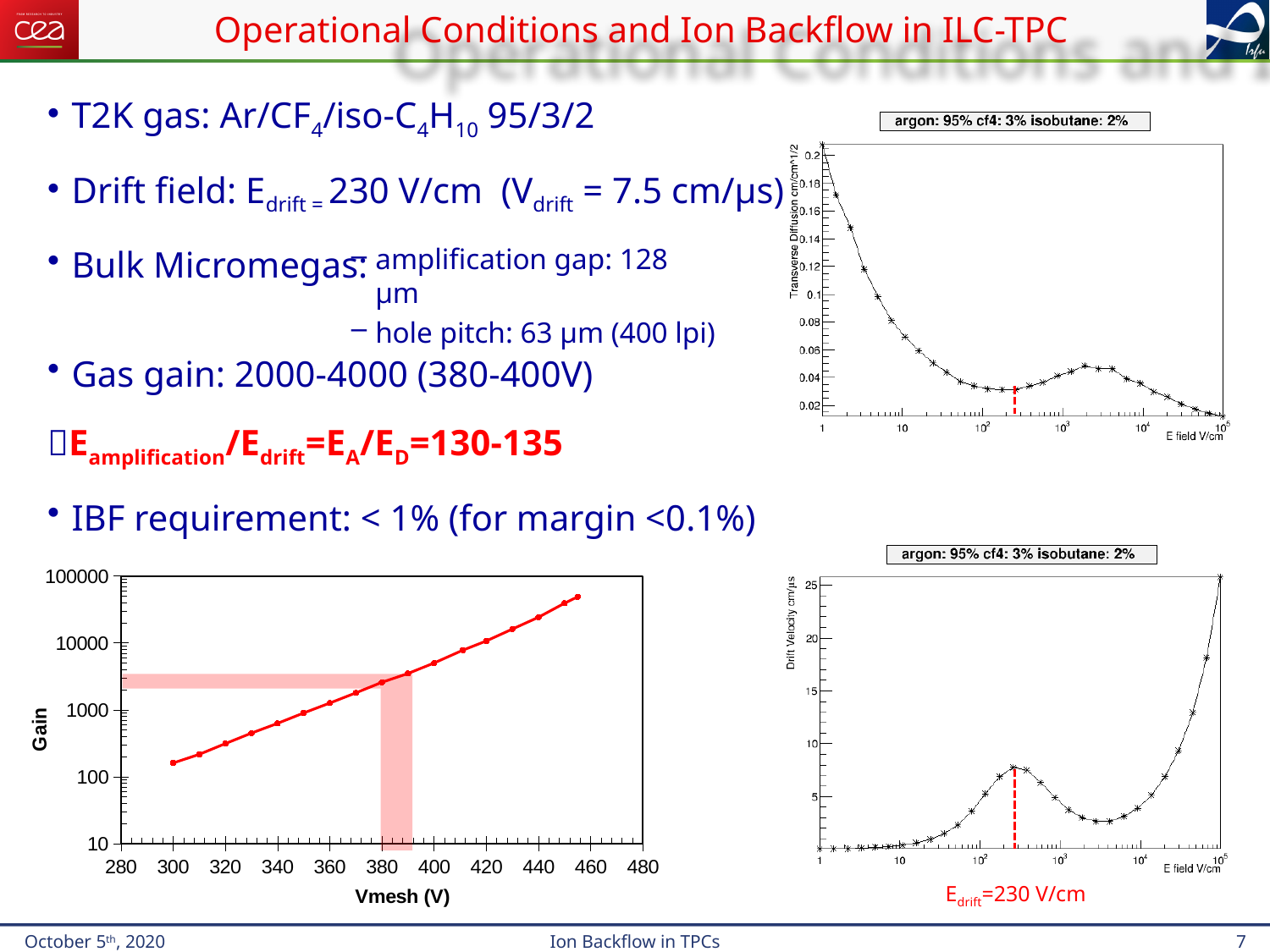
What kind of chart is the Gain versus Vmesh chart at the bottom left of the slide? line chart In the Gain versus Vmesh chart, is the gain at Vmesh = 450 V greater or less than 10000? greater In the Gain versus Vmesh chart, which has the larger gain: Vmesh = 340 V or Vmesh = 420 V? Vmesh = 420 V What is the title shown above the Transverse Diffusion chart at the top right of the slide? argon: 95% cf4: 3% isobutane: 2% In the Gain versus Vmesh chart, is the gain at Vmesh = 300 V greater or less than 100? greater What is the x-axis label of the Gain chart at the bottom left of the slide? Vmesh (V) In the Drift Velocity chart at the bottom right, is the drift velocity at E field = 10^5 V/cm greater or less than 20? greater In the Gain versus Vmesh chart, does the gain rise or fall as Vmesh increases? rise